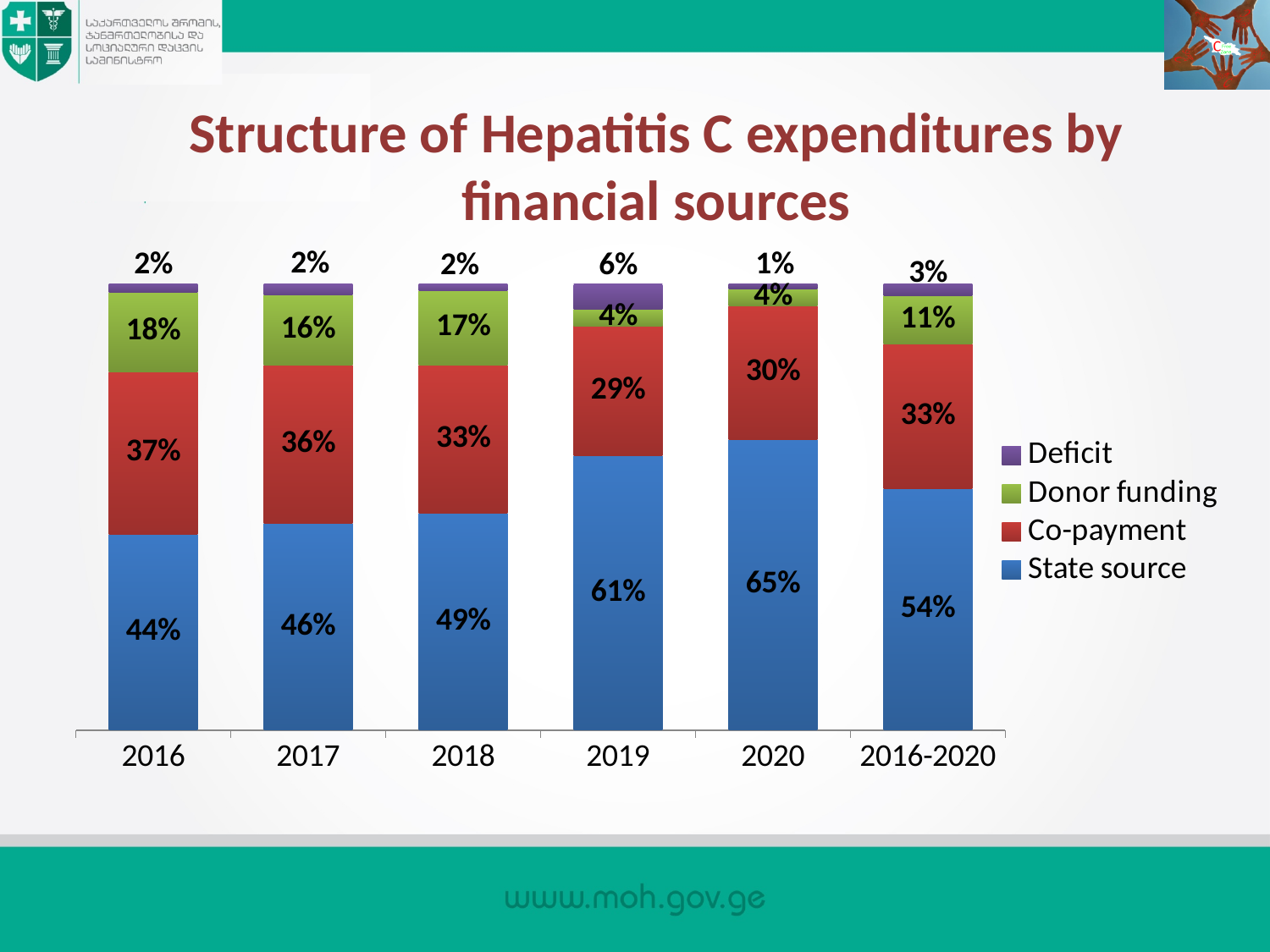
How many series does the legend list? 4 What is the State source share for 2020? 65% What is the difference between the State source share in 2020 and in 2016? 21% What is the Co-payment share for 2016? 37% What is the Deficit share for 2019? 6% Does the State source share rise or fall from 2016 to 2020? Rise How many categories are shown on the x axis? 6 What kind of chart is shown on the slide? Stacked bar chart Is the Co-payment share larger in 2017 or in 2019? 2017 Which category has the highest State source share? 2020 What is the Donor funding share for 2016-2020? 11%